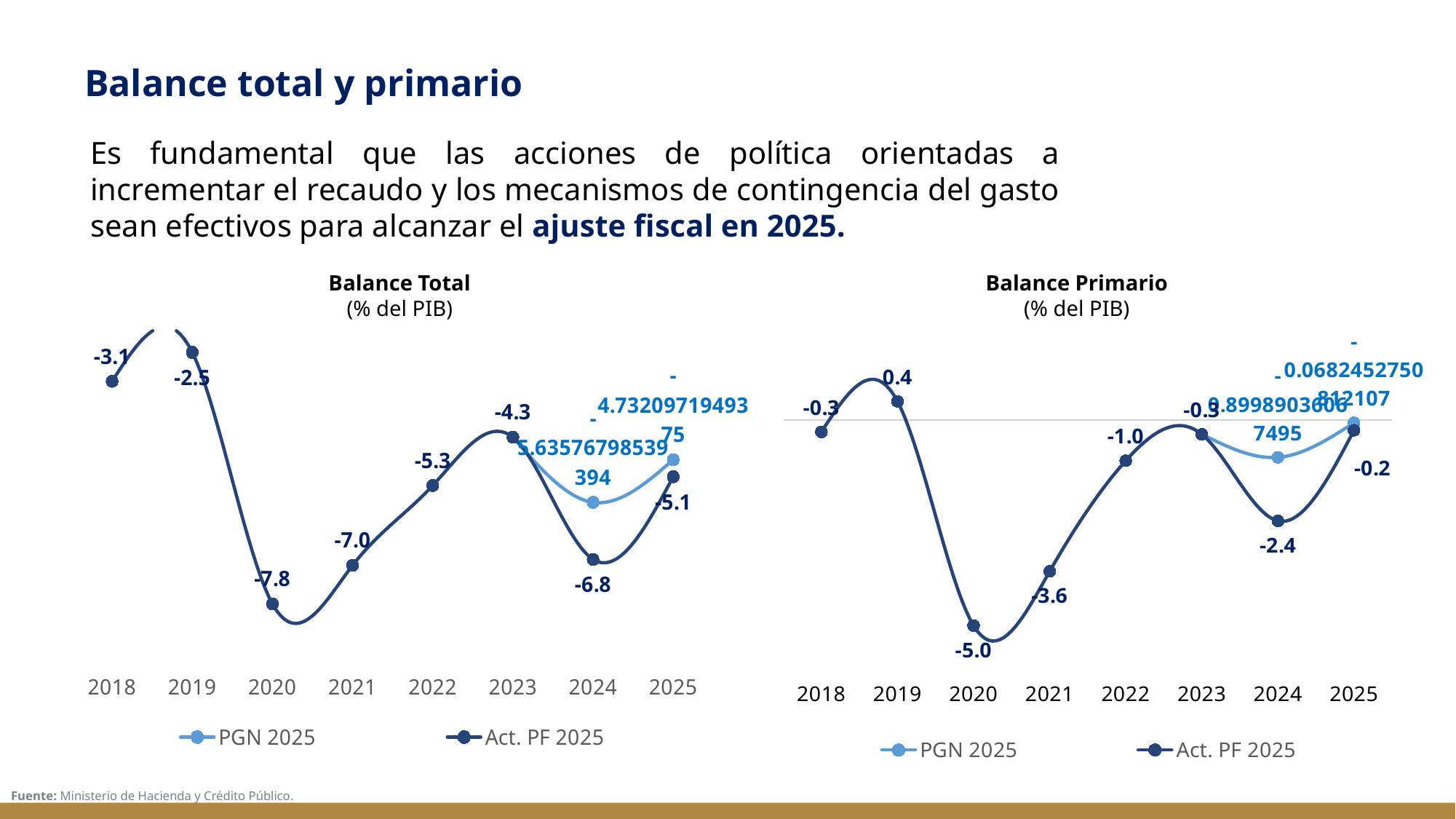
In the Balance Total chart, what is the Act. PF 2025 value for 2020? -7.8 In the Balance Total chart, what is the difference between the Act. PF 2025 values for 2024 and 2025? 1.7 In the Balance Primario chart, what is the Act. PF 2025 value for 2024? -2.4 In the Balance Primario chart, is the Act. PF 2025 value for 2021 larger or smaller than the value for 2022? smaller What kind of chart is the Balance Total chart? line chart How many years are shown on the x axis of the Balance Total chart? 8 In the Balance Total chart, which year has the lowest Act. PF 2025 value? 2020 In the Balance Primario chart, which year has the lowest Act. PF 2025 value? 2020 In the Balance Total chart, what is the Act. PF 2025 value for 2023? -4.3 In the Balance Total chart, which year has the highest Act. PF 2025 value? 2019 In the Balance Primario chart, what is the Act. PF 2025 value for 2019? 0.4 How many series does the legend of the Balance Primario chart list? 2